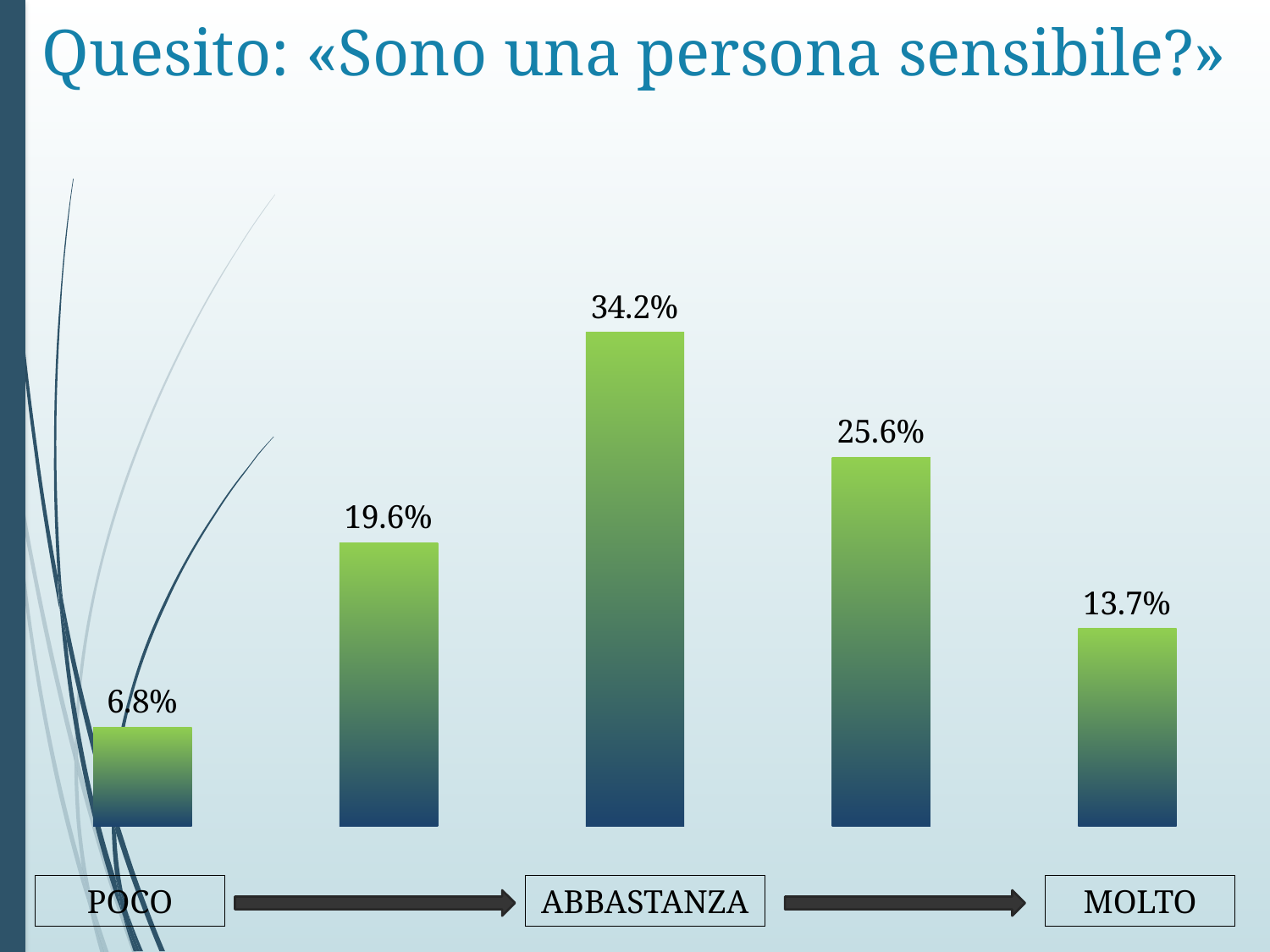
What is the value of the bar labelled POCO? 6.8% Which is larger, the value for MOLTO or the value for POCO? MOLTO What is the value of the bar labelled MOLTO? 13.7% What kind of chart is shown on the slide? bar chart Which bar has the highest value? ABBASTANZA What is the title of the slide containing the chart? Quesito: «Sono una persona sensibile?» What is the value of the second bar from the left? 19.6% What is the value of the fourth bar from the left? 25.6% What is the difference between the ABBASTANZA bar and the MOLTO bar? 20.5% What is the value of the bar labelled ABBASTANZA? 34.2% How many bars does the chart contain? 5 Which bar has the lowest value? POCO